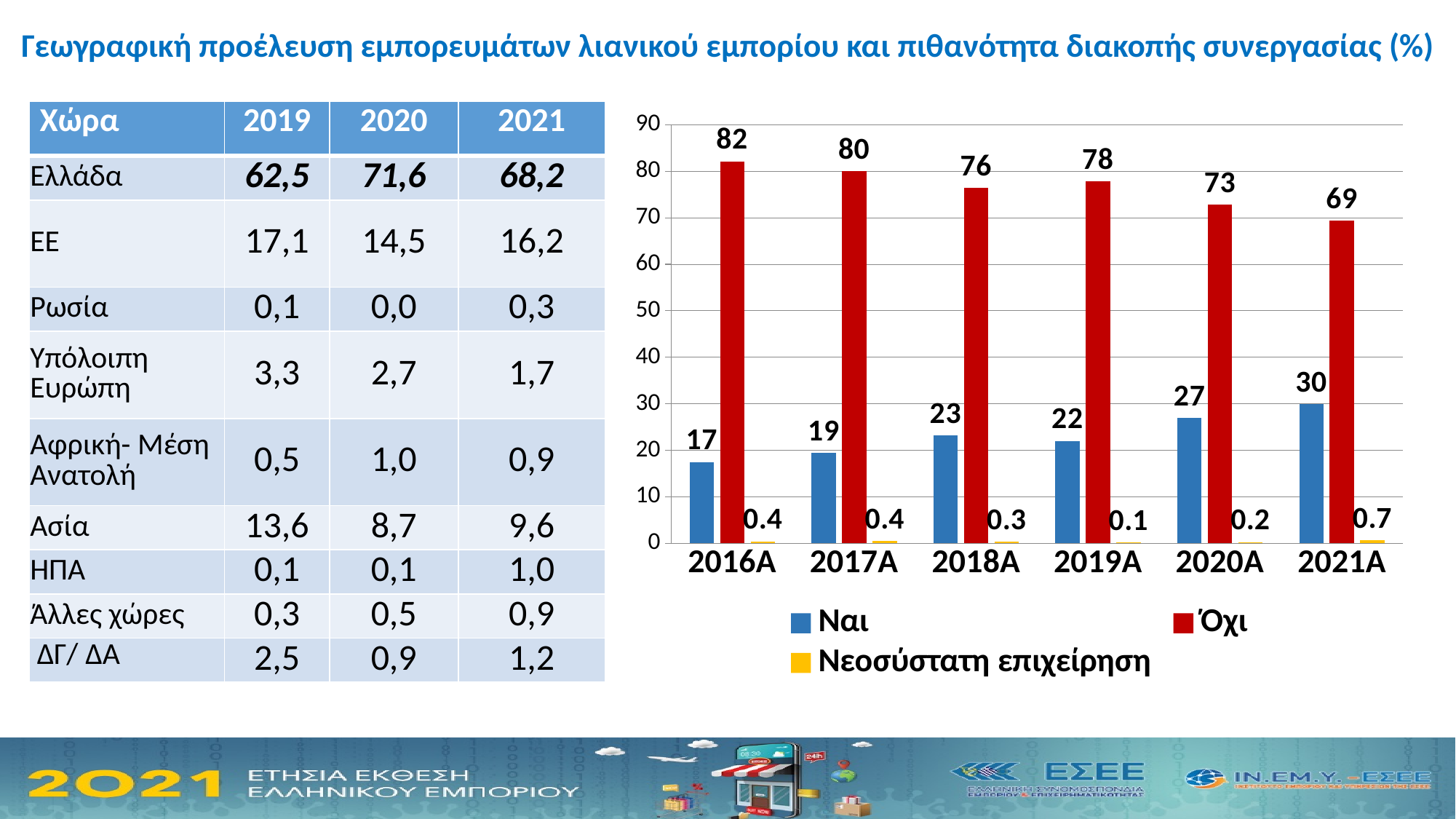
In the bar chart, which year has the highest value for Ναι? 2021A In the bar chart, does the Όχι series generally rise or fall from 2016A to 2021A? Fall In the bar chart, how many years are shown on the x axis? 6 In the bar chart, what is the value for Νεοσύστατη επιχείρηση in 2019A? 0.1 In the bar chart, what is the difference between the Όχι value and the Ναι value in 2018A? 53 In the bar chart, what is the value for Όχι in 2016A? 82 In the bar chart, which colour represents the Όχι series? Red In the bar chart, is the Ναι value larger in 2019A or in 2020A? 2020A In the bar chart, what is the value for Ναι in 2021A? 30 What kind of chart is shown on the right side of the slide? Bar chart How many series does the legend of the bar chart list? 3 In the bar chart, which year has the lowest value for Όχι? 2021A